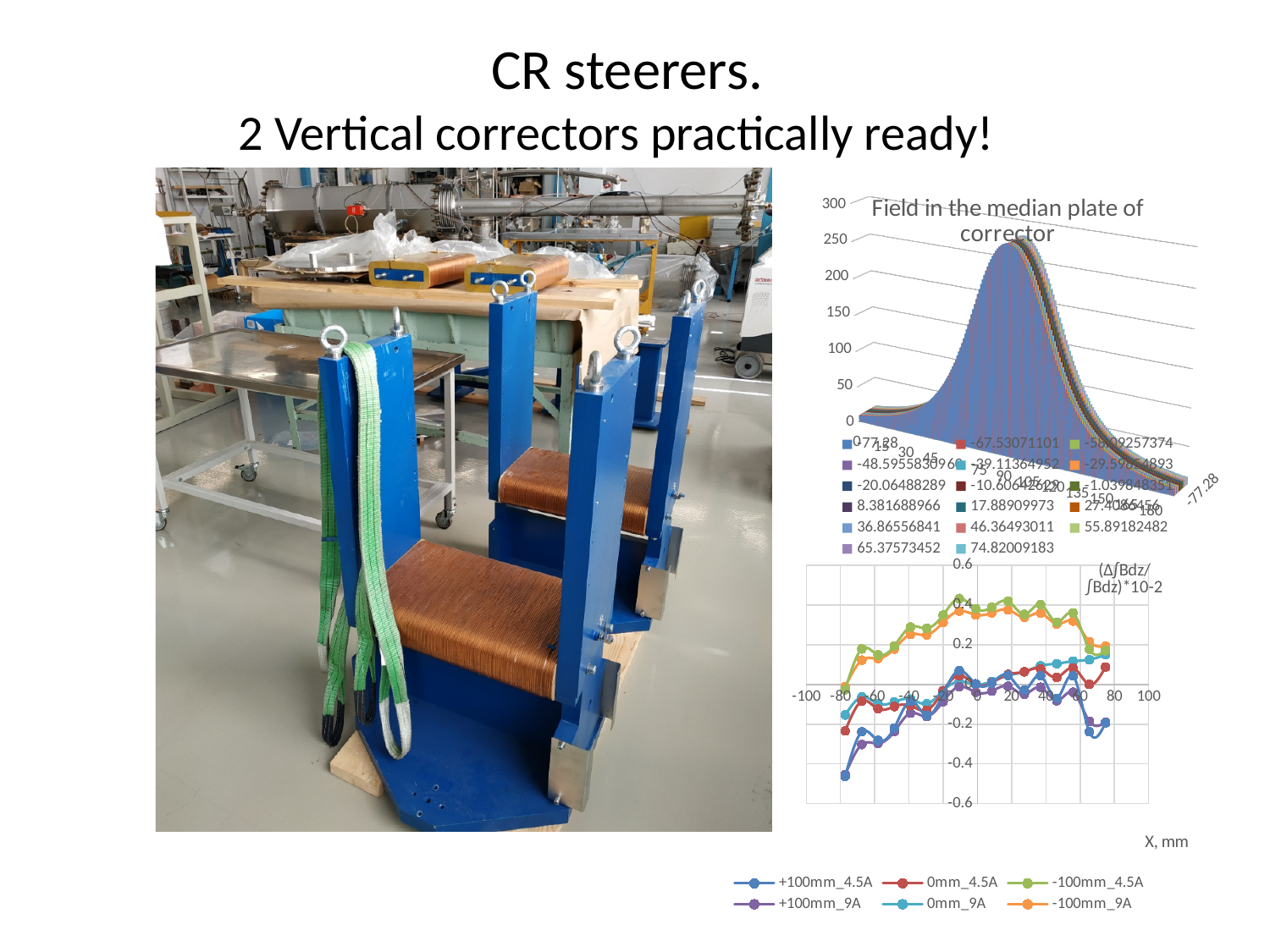
In the bottom-right line chart, is the value of -100mm_4.5A at X = -20 greater or less than 0.2? greater In the bottom-right line chart, is the value of +100mm_4.5A at X = -80 greater or less than -0.2? less What is the highest tick shown on the vertical axis of the 'Field in the median plate of corrector' chart? 300 In the 'Field in the median plate of corrector' chart, is the peak value greater or less than 200? greater What kind of chart is the 'Field in the median plate of corrector' chart? area chart What is the x-axis label of the bottom-right line chart? X, mm What is the title of the 3D chart at the top right of the slide? Field in the median plate of corrector In the bottom-right line chart, at X = 0, which series has the larger value: -100mm_4.5A or +100mm_4.5A? -100mm_4.5A In the bottom-right line chart, which series has the lowest value at X = -80? +100mm_4.5A In the 'Field in the median plate of corrector' chart, do the values rise or fall along the x axis from 0 to 75? rise What kind of chart is the bottom-right chart with the legend entries +100mm_4.5A and 0mm_9A? line chart How many series does the legend of the bottom-right line chart list? 6